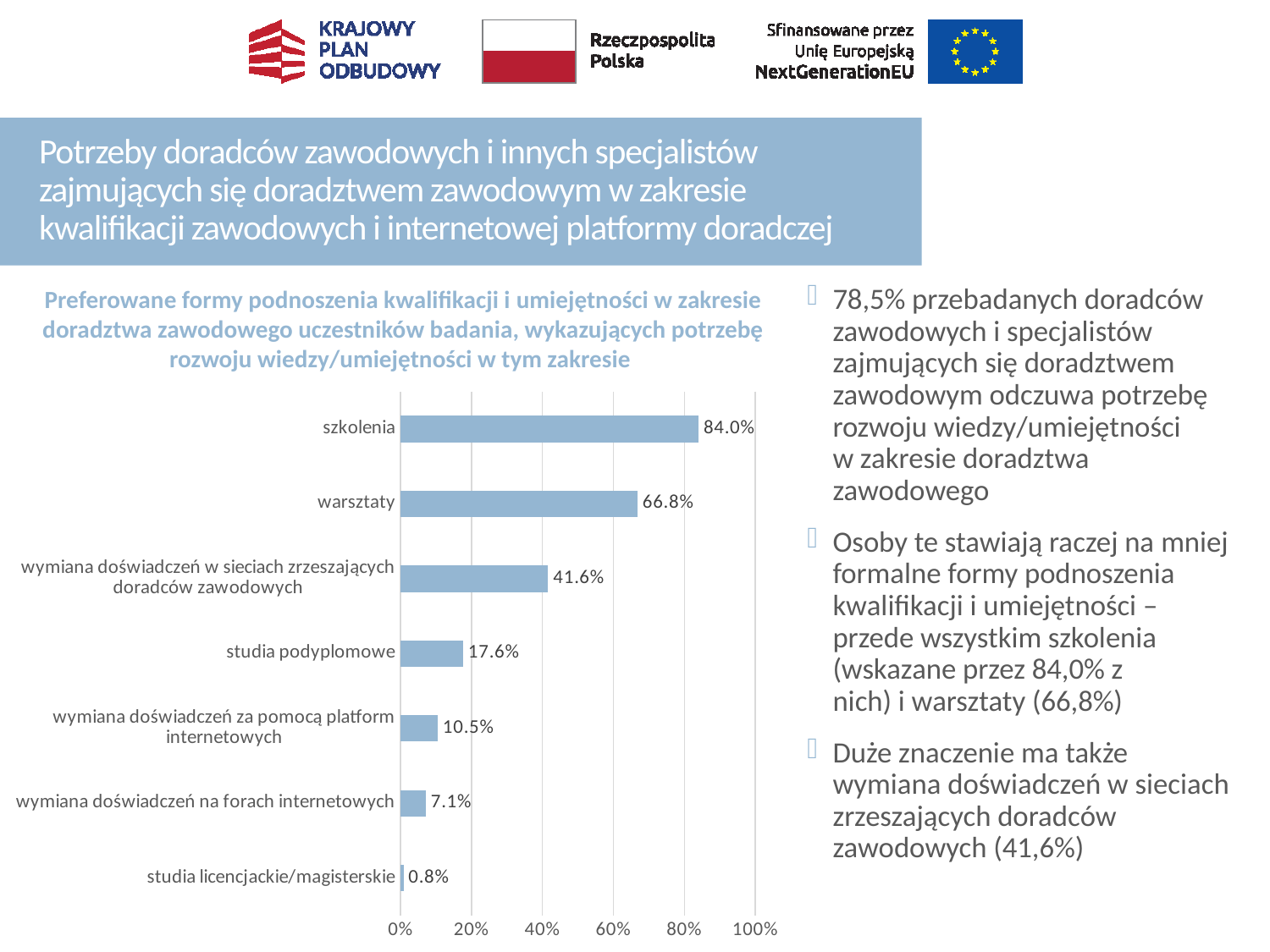
Which is larger, the value for studia podyplomowe or the value for wymiana doświadczeń za pomocą platform internetowych? studia podyplomowe What kind of chart is shown on the slide? bar chart What is the highest tick label on the horizontal axis? 100% What is the value for studia podyplomowe? 17.6% What is the value for szkolenia? 84.0% What is the value for warsztaty? 66.8% Which category has the highest value? szkolenia Which category has the lowest value? studia licencjackie/magisterskie What is the value for wymiana doświadczeń na forach internetowych? 7.1% How many categories are shown in the chart? 7 Is the value for wymiana doświadczeń w sieciach zrzeszających doradców zawodowych greater or less than 40%? greater What is the difference between the values for szkolenia and warsztaty? 17.2%